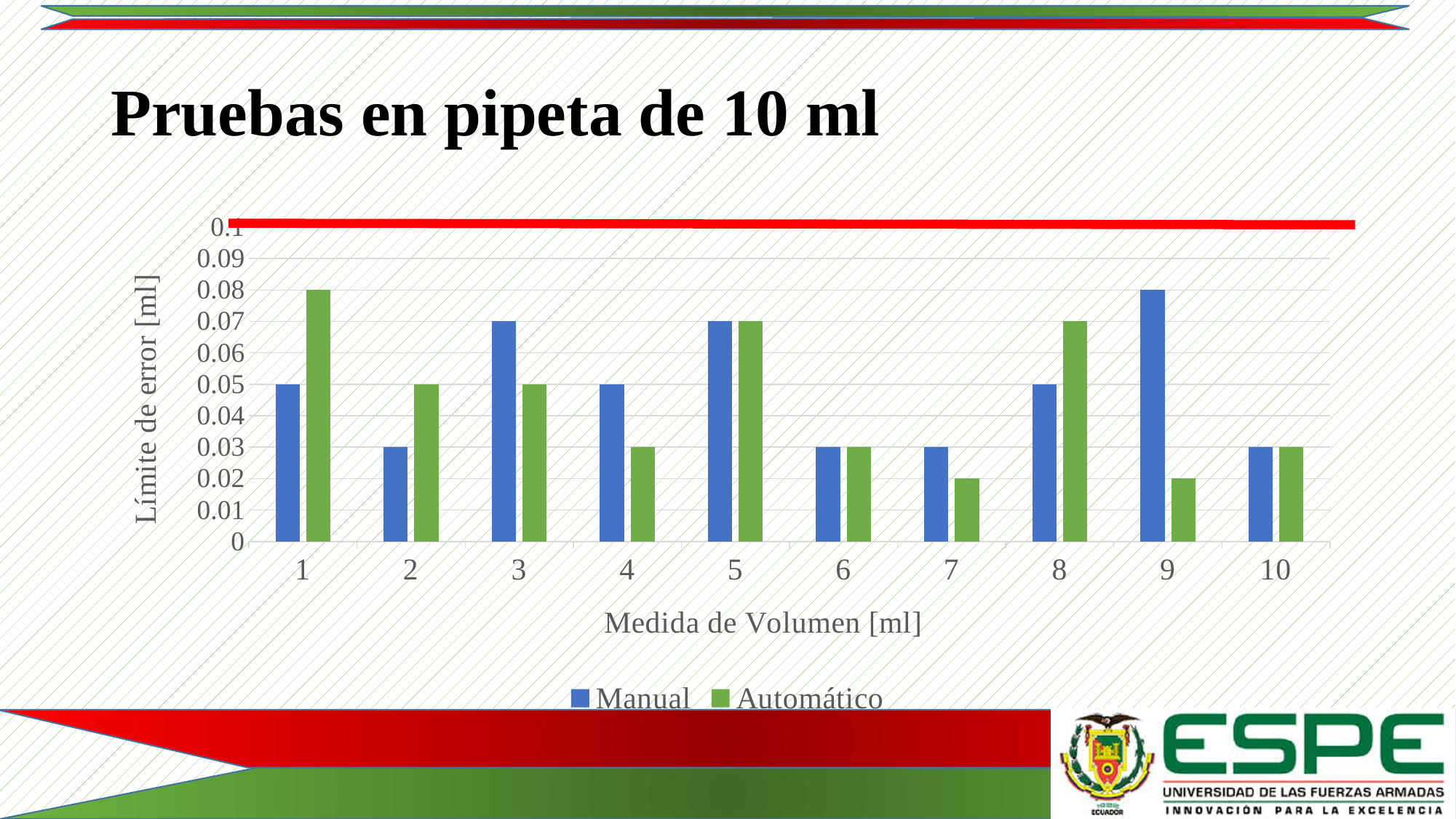
How many volume measurements (categories) are shown on the x axis? 10 What kind of chart is shown on the slide? bar chart What is the difference between the Automático and Manual error limits for volume measurement 1? 0.03 How many series does the legend list? 2 For which volume measurement is the Automático error limit highest? 1 What is the Automático error limit for volume measurement 1? 0.08 For which volume measurement is the Manual error limit highest? 9 What is the Manual error limit for volume measurement 3? 0.07 Is the Manual error limit for volume measurement 9 greater or less than 0.05? greater What is the Manual error limit for volume measurement 9? 0.08 For volume measurement 8, which series has the larger error limit, Manual or Automático? Automático What is the label of the y axis? Límite de error [ml]